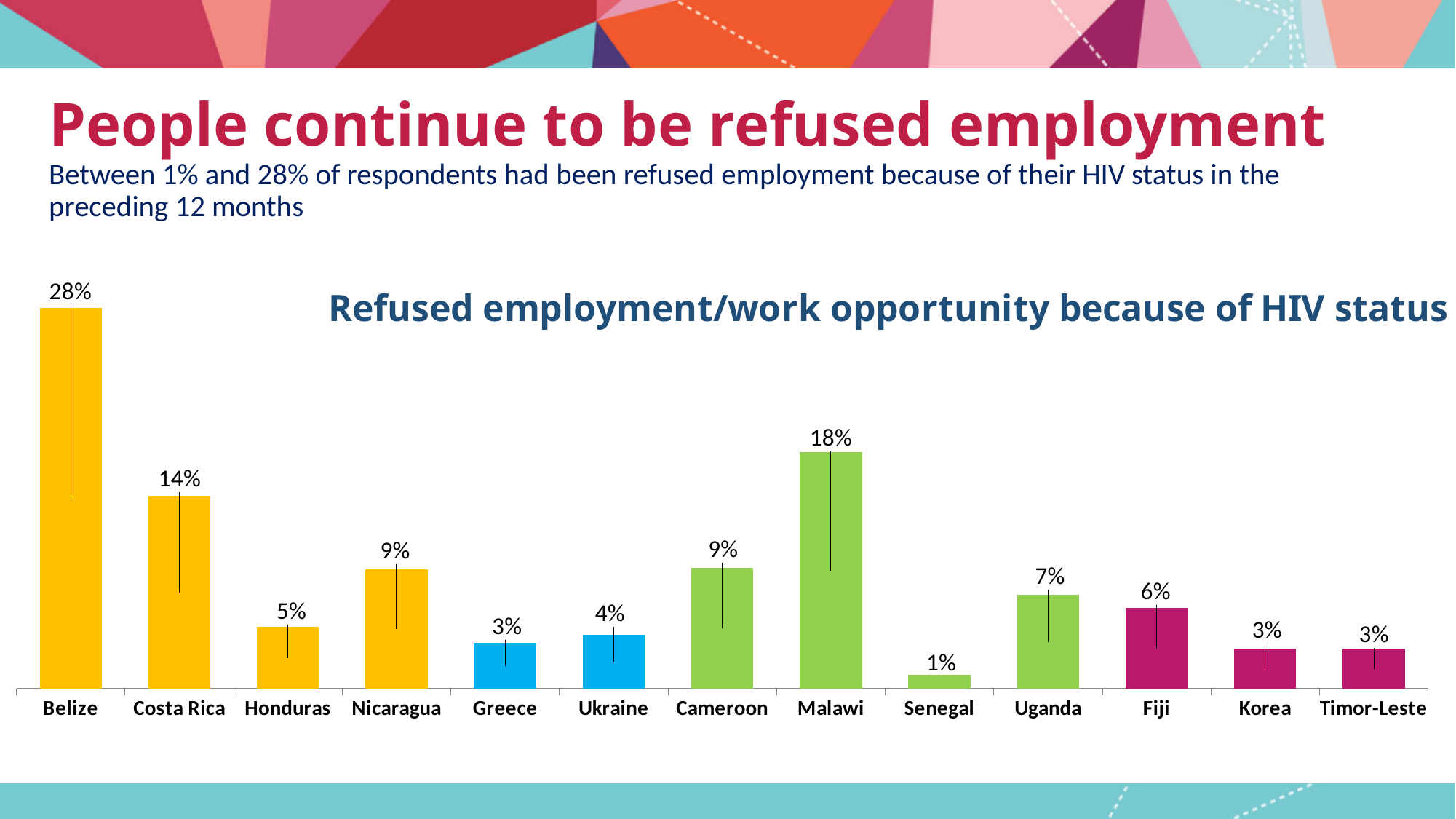
What is the value for Uganda? 7% What kind of chart is shown on the slide? Bar chart What is the title of the chart? Refused employment/work opportunity because of HIV status What is the difference between the values for Belize and Costa Rica? 14% How many countries are shown on the chart? 13 What is the value for Malawi? 18% What is the difference between the values for Malawi and Cameroon? 9% Which is larger, the value for Fiji or the value for Ukraine? Fiji Which country has the highest value? Belize Which is larger, the value for Nicaragua or the value for Honduras? Nicaragua What is the value for Belize? 28% Which country has the lowest value? Senegal